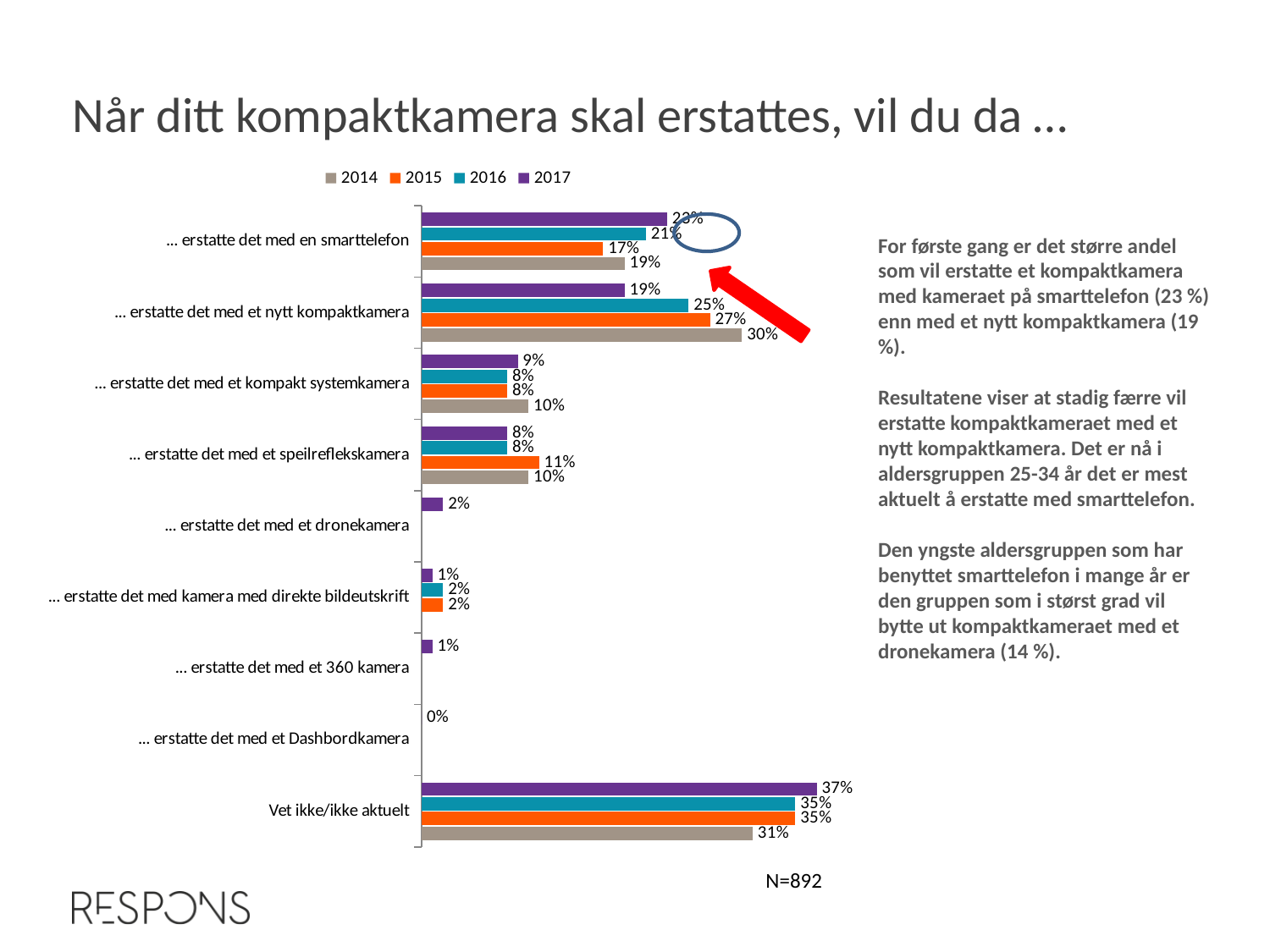
Do the values for "… erstatte det med et nytt kompaktkamera" rise or fall from 2014 to 2017? Fall Which year has the lowest value for "… erstatte det med et nytt kompaktkamera"? 2017 How many series does the legend list? 4 For "… erstatte det med en smarttelefon", is the 2015 value or the 2014 value larger? 2014 What is the 2015 value for "… erstatte det med et speilreflekskamera"? 11% What is the 2016 value for "… erstatte det med en smarttelefon"? 21% What is the 2014 value for "… erstatte det med et nytt kompaktkamera"? 30% Which category has the highest 2017 value? Vet ikke/ikke aktuelt What is the difference between the 2014 and 2017 values for "… erstatte det med et nytt kompaktkamera"? 11% What is the 2017 value for "Vet ikke/ikke aktuelt"? 37% What kind of chart is shown on the slide? Bar chart How many categories are shown on the chart? 9